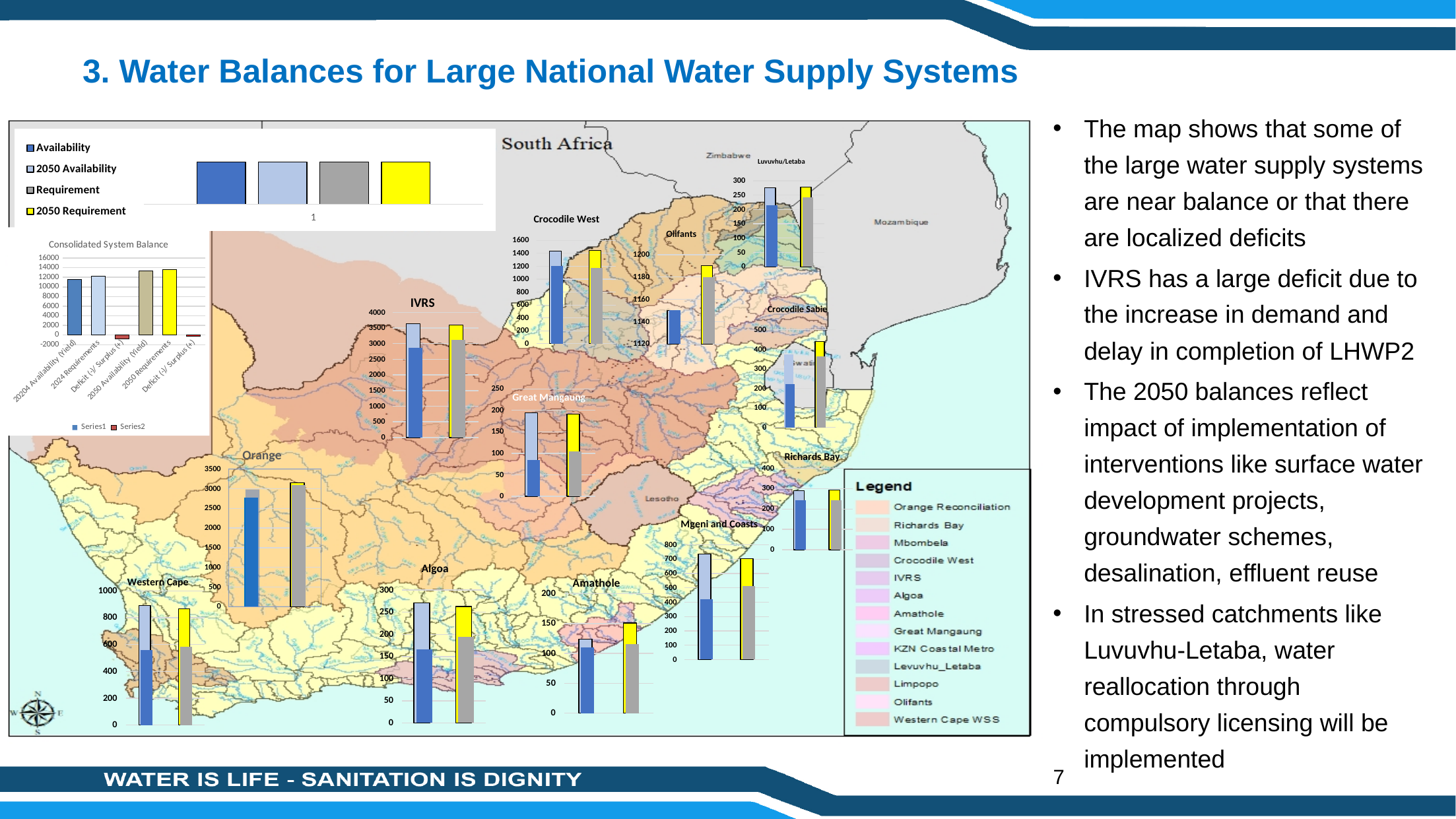
In the Mgeni and Coasts chart, which is larger, Availability or 2050 Availability? 2050 Availability In the Mgeni and Coasts chart, is the value for 2050 Availability greater or less than 600? greater What is the title of the small chart at the top left of the map below the legend? Consolidated System Balance In the Crocodile West chart, is the value for 2050 Availability greater or less than 1000? greater What kind of chart is the IVRS chart on the map? bar chart How many series does the legend at the top left of the map list? 4 In the Consolidated System Balance chart, is the value for 2024 Availability (Yield) greater or less than 10000? greater In the Western Cape chart, which is larger, Availability or 2050 Availability? 2050 Availability In the Consolidated System Balance chart, how many categories are shown on the x axis? 6